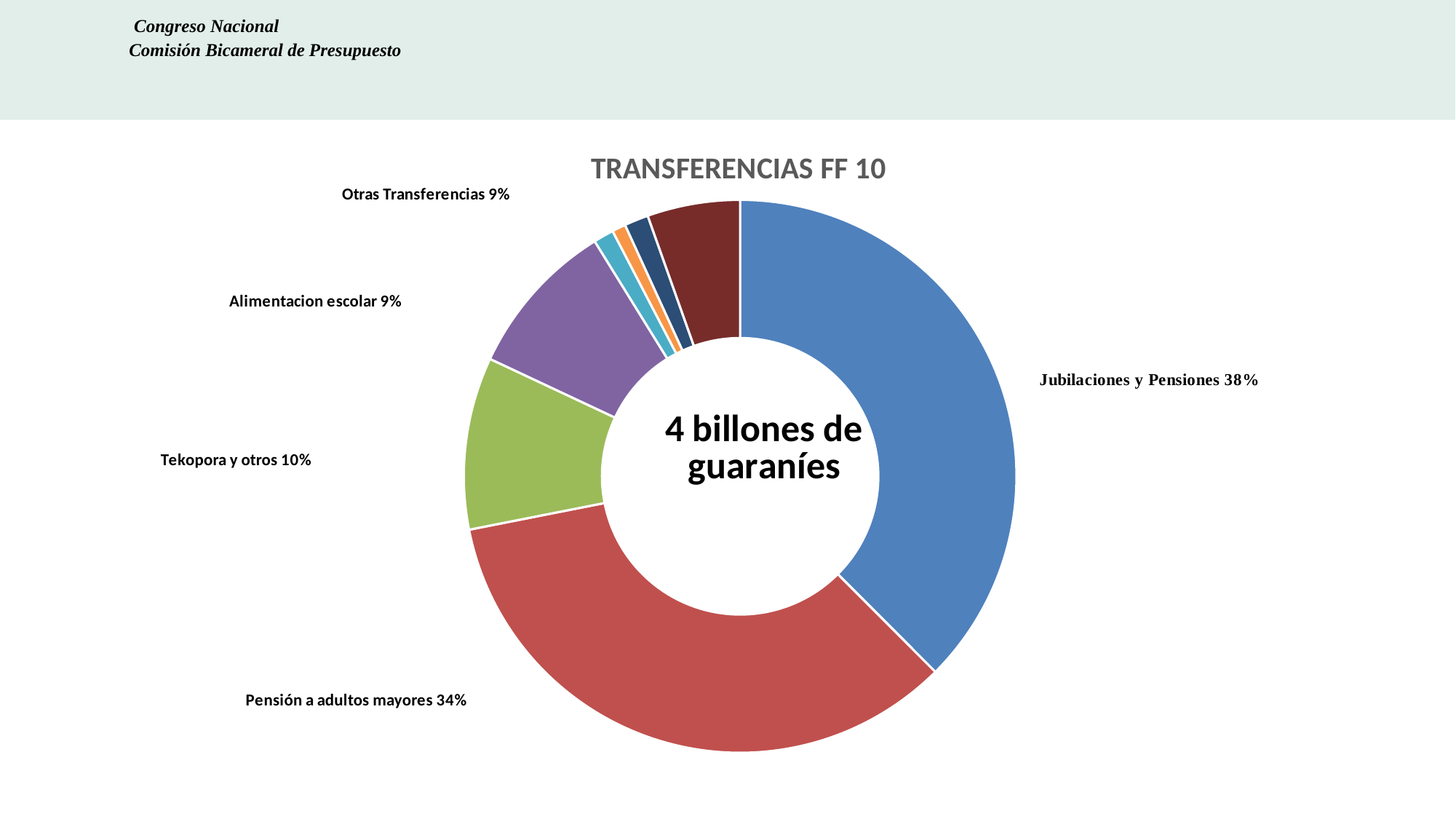
Which is larger, Tekopora y otros or Otras Transferencias? Tekopora y otros By how many percentage points does Jubilaciones y Pensiones exceed Pensión a adultos mayores? 4 percentage points Which category has the largest share of the chart? Jubilaciones y Pensiones What is the difference in percentage points between Tekopora y otros and Alimentacion escolar? 1 percentage point What percentage is shown for Alimentacion escolar? 9% What percentage is shown for Pensión a adultos mayores? 34% How many slices of the chart are labeled with a percentage? 5 What share of the TRANSFERENCIAS FF 10 chart is Jubilaciones y Pensiones? 38% What percentage is shown for Tekopora y otros? 10% What text appears in the center of the doughnut chart? 4 billones de guaraníes What type of chart is shown on the slide? Doughnut (pie) chart Which is larger, Jubilaciones y Pensiones or Pensión a adultos mayores? Jubilaciones y Pensiones